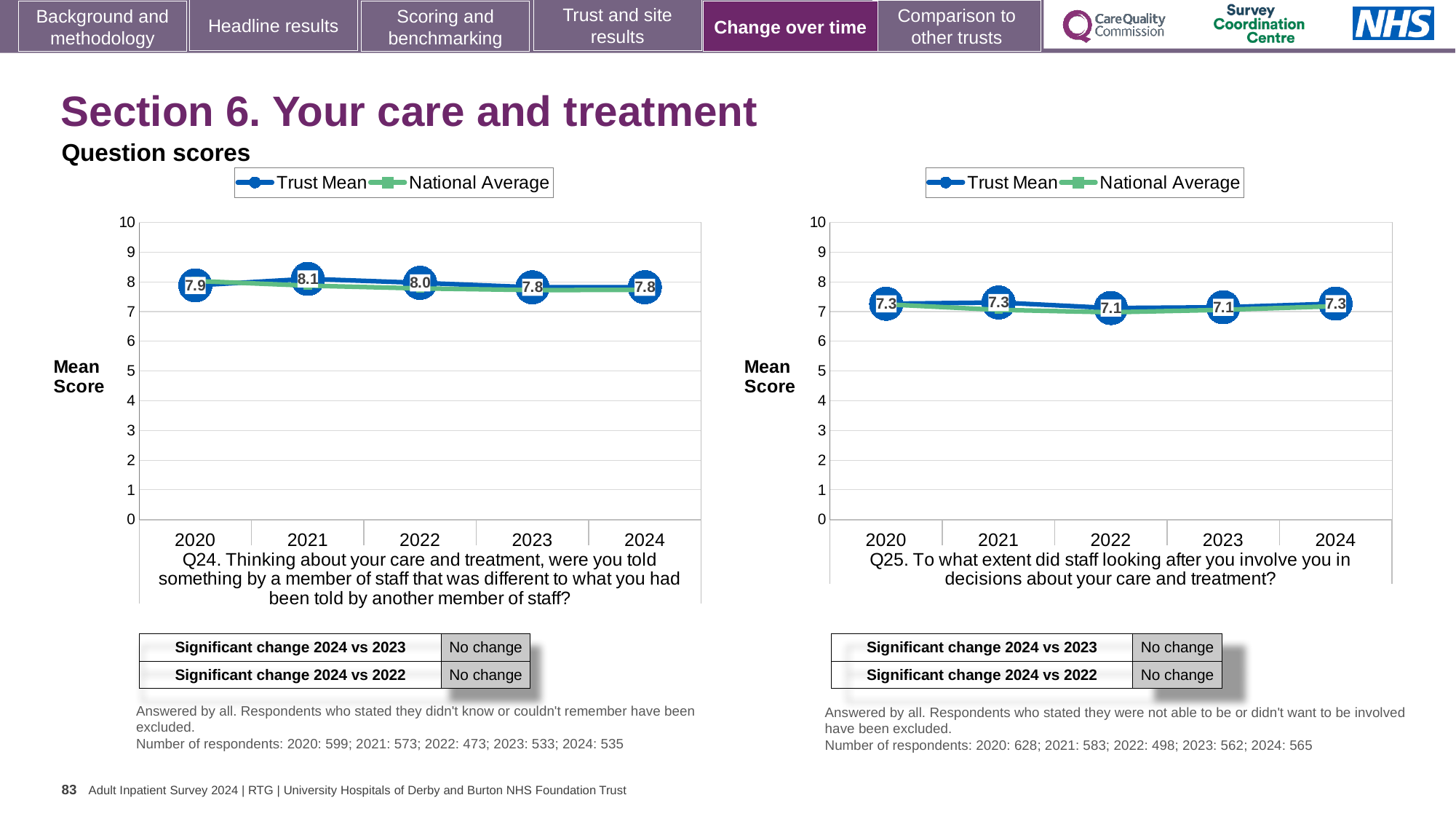
How many years are plotted on the x axis of the Q25 chart on the right? 5 In the Q25 chart on the right, what is the Trust Mean score for 2024? 7.3 In the Q24 chart on the left, which year has the highest Trust Mean score? 2021 What kind of chart is the Q25 chart on the right? Line chart In the Q25 chart on the right, what is the difference between the Trust Mean scores for 2024 and 2022? 0.2 In the Q24 chart on the left, what is the Trust Mean score for 2024? 7.8 In the Q24 chart on the left, what is the Trust Mean score for 2021? 8.1 In the Q25 chart on the right, what is the Trust Mean score for 2022? 7.1 In the Q24 chart on the left, which year has the larger Trust Mean score, 2021 or 2023? 2021 In the Q24 chart on the left, what is the difference between the Trust Mean scores for 2021 and 2024? 0.3 In the Q24 chart on the left, is the National Average value for 2024 greater or less than 7? greater How many series does the legend of the Q24 chart on the left list? 2